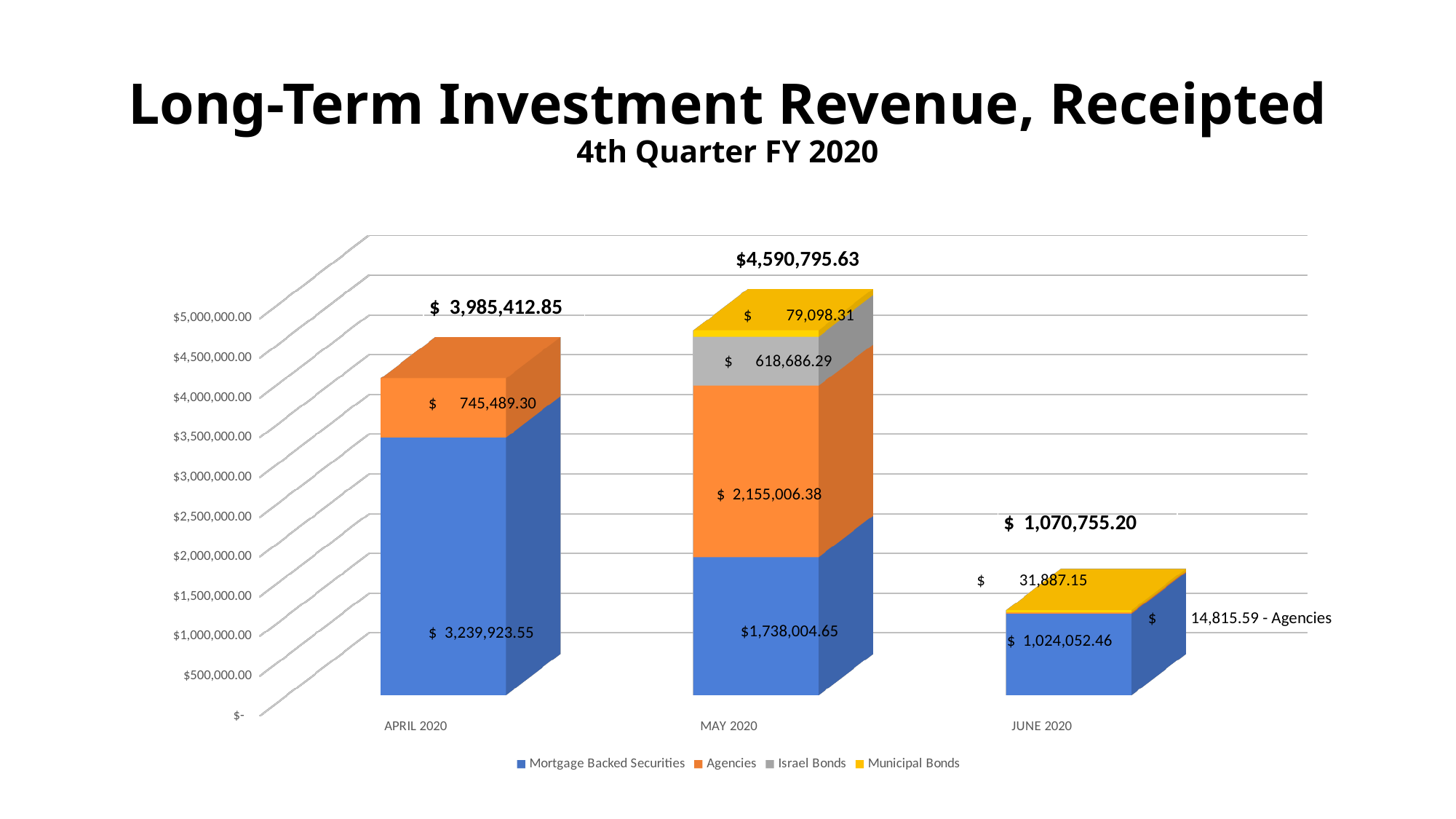
What is the total of the stacked bar for May 2020? $4,590,795.63 What kind of chart is shown on the slide? Stacked bar chart What is the total of the stacked bar for June 2020? $1,070,755.20 What is the value for Mortgage Backed Securities in April 2020? $3,239,923.55 How many series does the legend list? 4 Which is larger, the Agencies value in April 2020 or the Agencies value in May 2020? May 2020 What is the value for Municipal Bonds in June 2020? $31,887.15 What is the value for Israel Bonds in May 2020? $618,686.29 What is the value for Agencies in May 2020? $2,155,006.38 What is the difference between the Mortgage Backed Securities values for April 2020 and May 2020? $1,501,918.90 Which month has the lowest total revenue? June 2020 Which month has the highest total revenue? May 2020